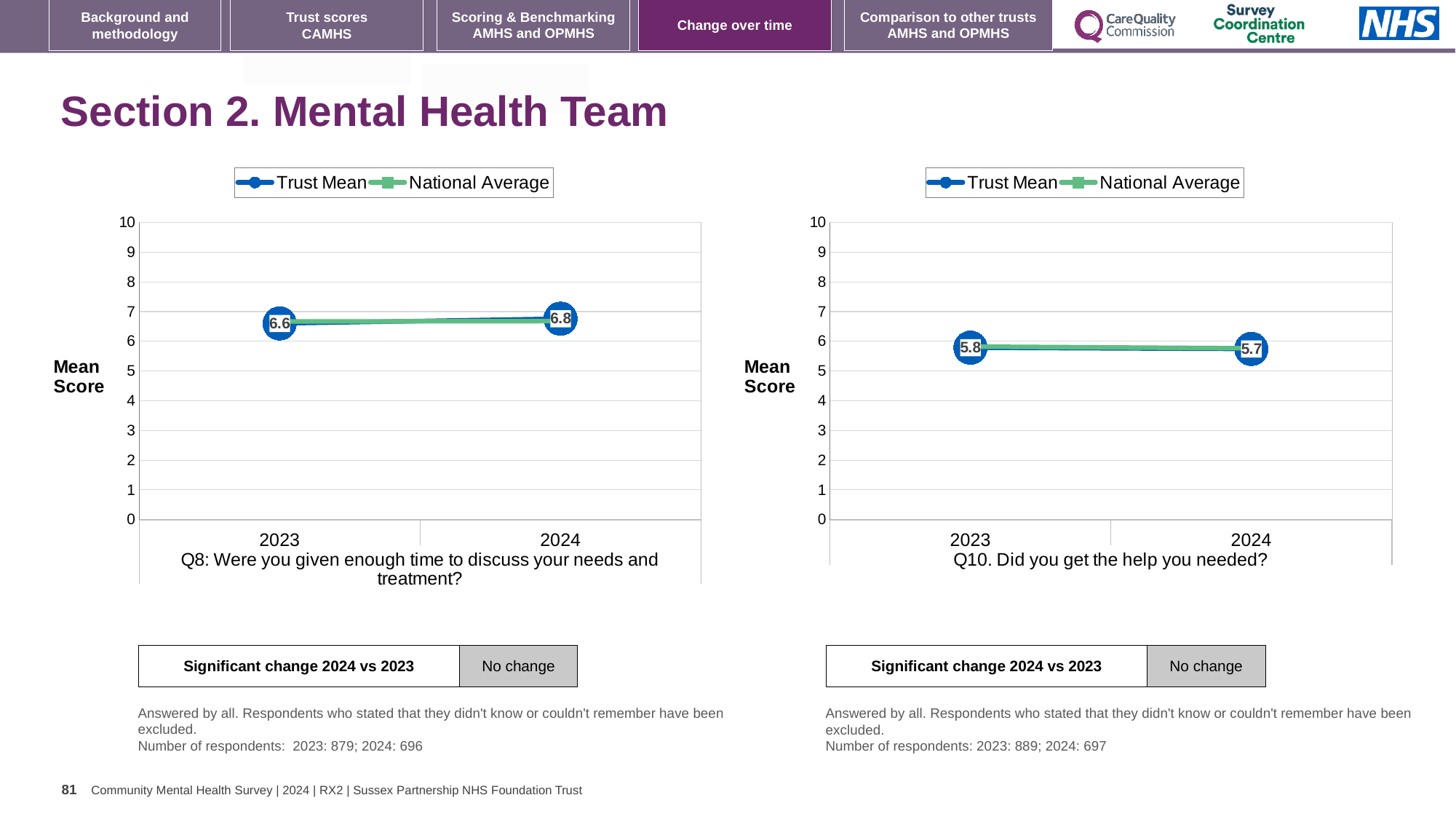
In the right chart (Q10. Did you get the help you needed?), what is the Trust Mean for 2024? 5.7 In the right chart (Q10), does the Trust Mean rise or fall from 2023 to 2024? fall In the right chart (Q10), is the Trust Mean for 2024 greater or less than 6? less In the right chart (Q10. Did you get the help you needed?), what is the Trust Mean for 2023? 5.8 In the left chart (Q8), does the Trust Mean rise or fall from 2023 to 2024? rise In the left chart (Q8), by how much did the Trust Mean change from 2023 to 2024? 0.2 In the right chart (Q10), what is the difference between the Trust Mean for 2023 and 2024? 0.1 How many years are plotted on the x axis of the left chart (Q8)? 2 In the left chart (Q8: Were you given enough time to discuss your needs and treatment?), what is the Trust Mean for 2023? 6.6 How many series does the legend of the left chart list? 2 What kind of chart is the right chart (Q10. Did you get the help you needed?)? line chart In the left chart (Q8: Were you given enough time to discuss your needs and treatment?), what is the Trust Mean for 2024? 6.8